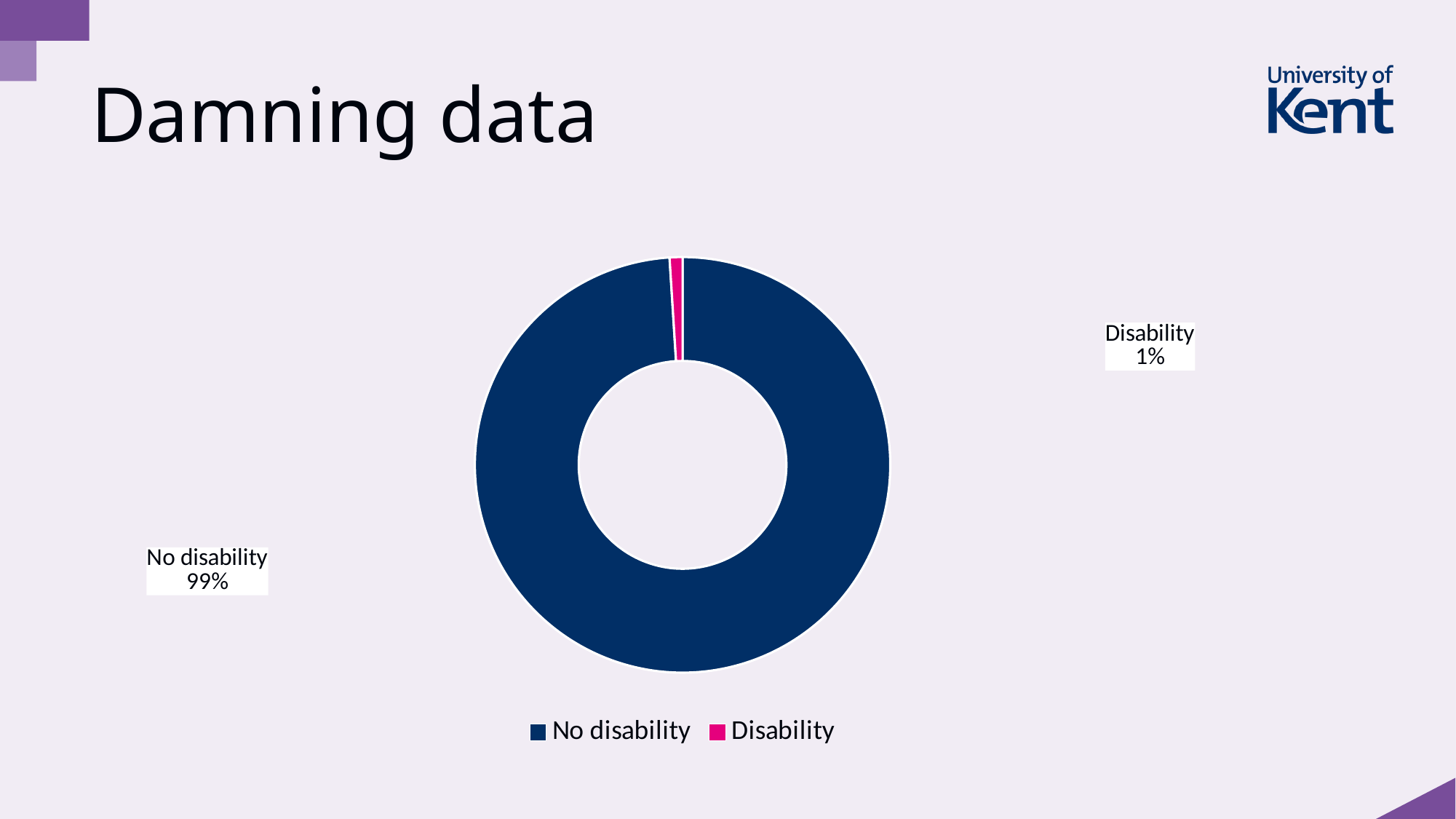
How many categories does the chart show? 2 What share of the pie does the "Disability" slice represent? 1% What colour is the "Disability" slice in the chart? Pink What percentage of the chart is labelled "No disability"? 99% Which category has the largest share of the chart? No disability Which is larger, the share for "No disability" or the share for "Disability"? No disability What is the difference in percentage points between the "No disability" and "Disability" shares? 98 What kind of chart is shown on the slide? Pie chart (doughnut) How many entries does the legend list? 2 What percentage of the chart is labelled "Disability"? 1% What is the title of the slide containing the chart? Damning data Which category has the smallest share of the chart? Disability